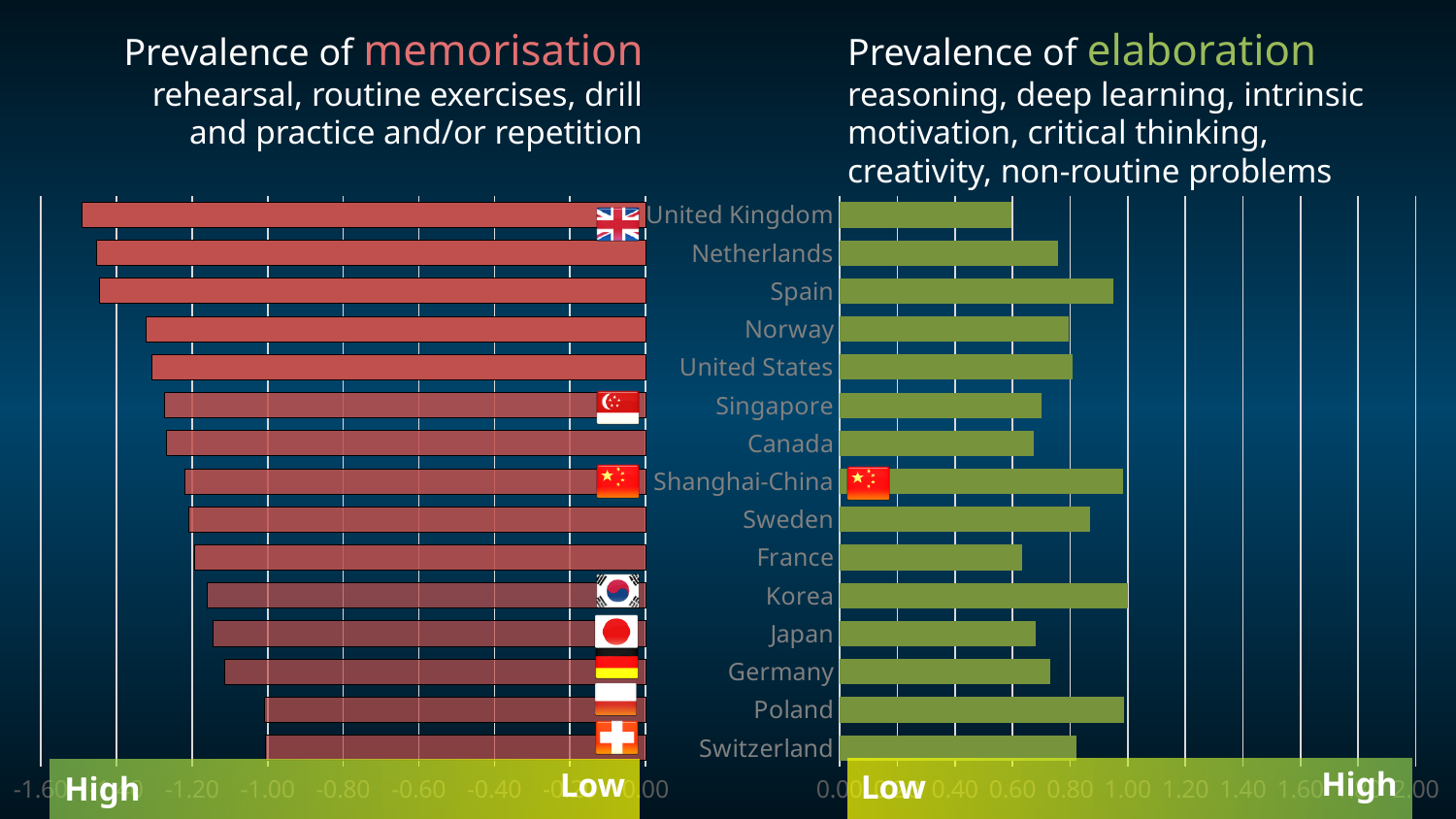
On the 'Prevalence of elaboration' chart, is the value for Netherlands greater or less than 0.60? greater On the 'Prevalence of elaboration' chart, is the value for Germany greater or less than 0.80? less What colour are the bars on the 'Prevalence of elaboration' chart? green How many countries are listed on the 'Prevalence of elaboration' chart? 15 On the 'Prevalence of elaboration' chart, is the value for Singapore greater or less than 0.80? less On the 'Prevalence of memorisation' chart, which country has the longest bar? United Kingdom What kind of chart is the 'Prevalence of memorisation' chart? bar chart On the 'Prevalence of memorisation' chart, which country has the longer bar, United Kingdom or Switzerland? United Kingdom On the 'Prevalence of elaboration' chart, which country has the larger value, Spain or Canada? Spain